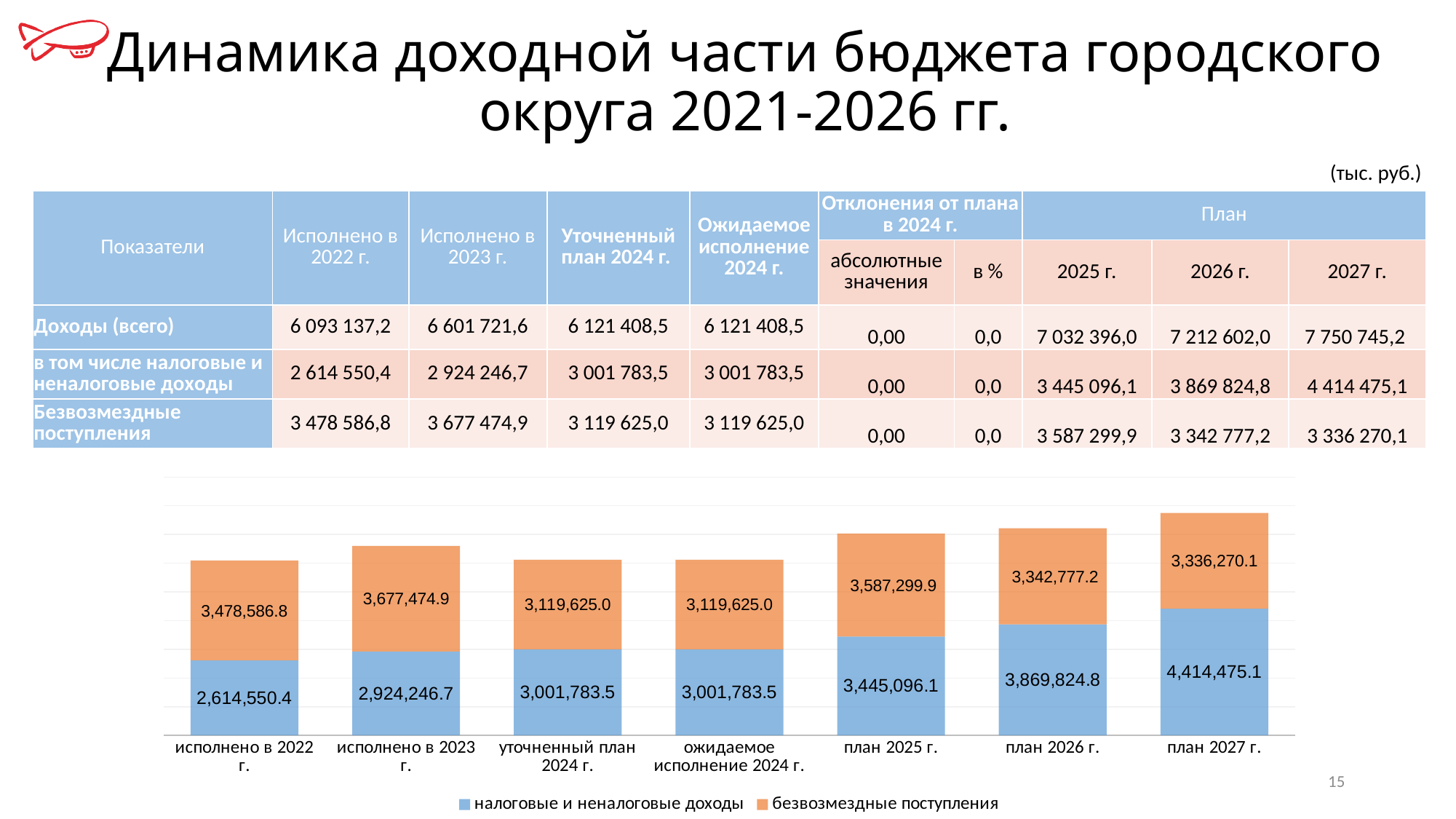
Which category has the lowest value for налоговые и неналоговые доходы in the chart? исполнено в 2022 г. What is the value of безвозмездные поступления for ожидаемое исполнение 2024 г. in the chart? 3,119,625.0 What is the value of безвозмездные поступления for план 2025 г. in the chart? 3,587,299.9 How many series does the chart legend list? 2 What is the value of налоговые и неналоговые доходы for исполнено в 2022 г. in the chart? 2,614,550.4 Which category has the highest value for безвозмездные поступления in the chart? исполнено в 2023 г. Which category has the highest value for налоговые и неналоговые доходы in the chart? план 2027 г. In the chart, what is the difference between налоговые и неналоговые доходы for план 2027 г. and for план 2026 г.? 544,650.3 What kind of chart is shown on the slide? Stacked bar chart What is the total of the stacked bar for план 2025 г. in the chart? 7,032,396.0 In the chart, which is larger for план 2026 г.: налоговые и неналоговые доходы or безвозмездные поступления? налоговые и неналоговые доходы How many categories are shown along the x axis of the chart? 7